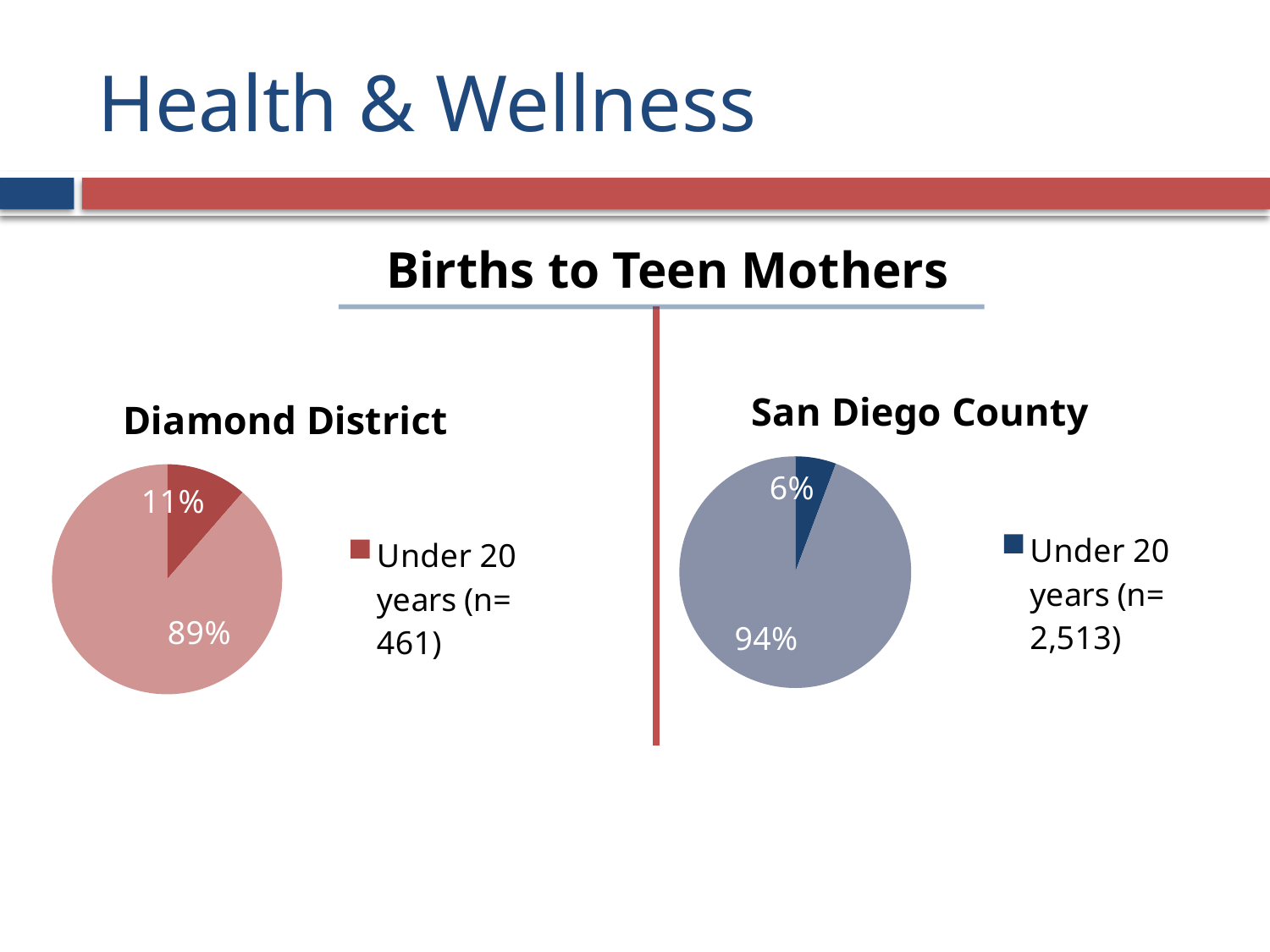
What sample size (n) is given in the legend of the San Diego County chart? 2,513 In the San Diego County pie chart, what percentage is shown for the larger slice? 94% Which has the larger share of births to mothers under 20 years, Diamond District or San Diego County? Diamond District What is the title shown above the two pie charts? Births to Teen Mothers In the Diamond District pie chart, what percentage is shown for the larger slice? 89% How many entries does the legend of the Diamond District chart list? 1 What kind of chart is used for the Diamond District data? Pie chart How many slices does the San Diego County pie chart have? 2 How many percentage points higher is the under-20 share in the Diamond District chart than in the San Diego County chart? 5 In the Diamond District pie chart, what share of births is to mothers under 20 years? 11% In the San Diego County pie chart, what share of births is to mothers under 20 years? 6%